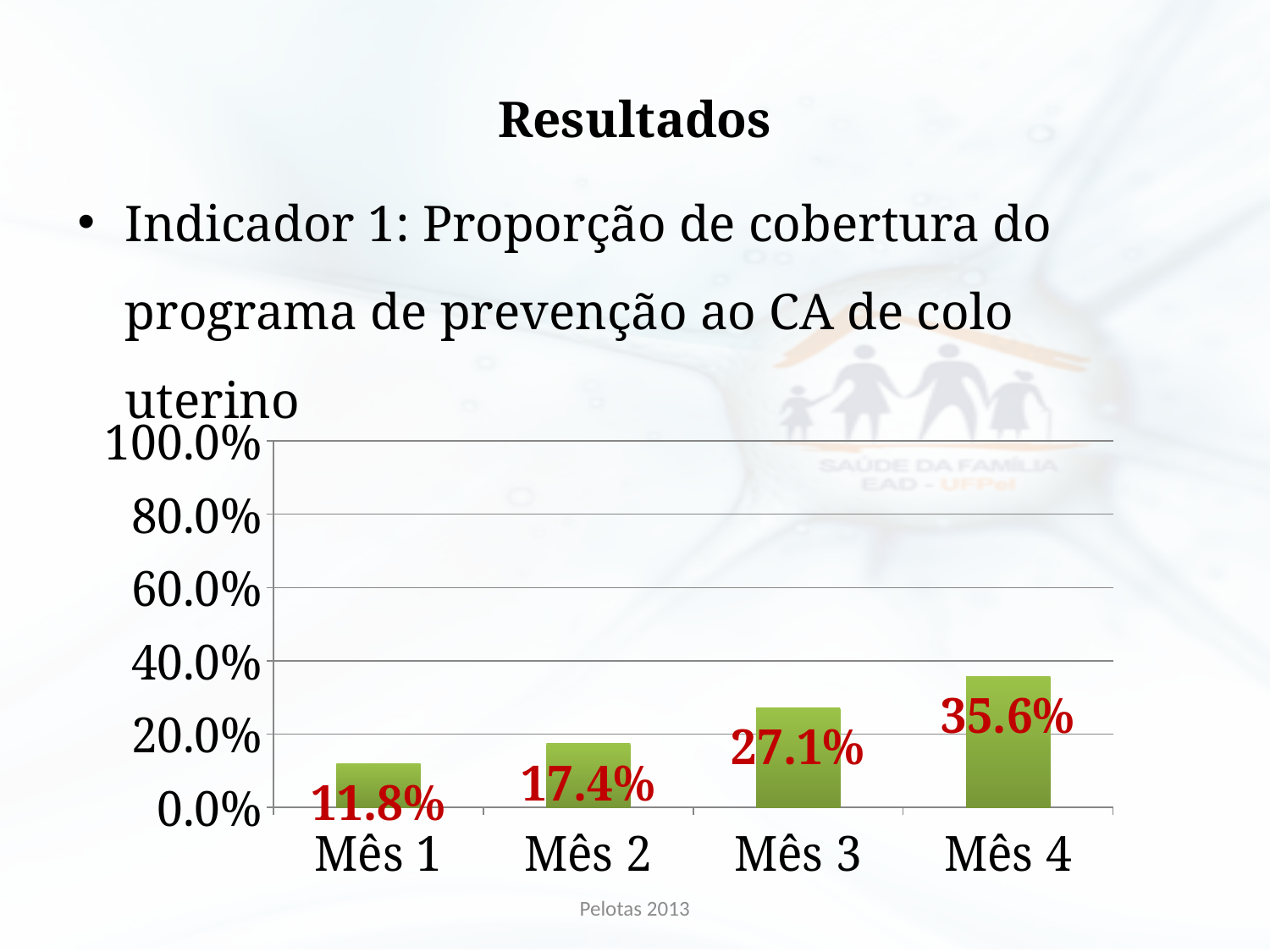
What is the value for Mês 1? 11.8% Which is larger, the value for Mês 2 or the value for Mês 3? Mês 3 What is the difference between the values for Mês 4 and Mês 1? 23.8% What is the value for Mês 4? 35.6% How many months are shown on the x axis? 4 What is the difference between the values for Mês 3 and Mês 2? 9.7% What is the value for Mês 3? 27.1% Which month has the lowest value? Mês 1 Which month has the highest value? Mês 4 What kind of chart is shown on the slide? bar chart Is the value for Mês 4 greater or less than 40.0%? less Do the values rise or fall from Mês 1 to Mês 4? rise